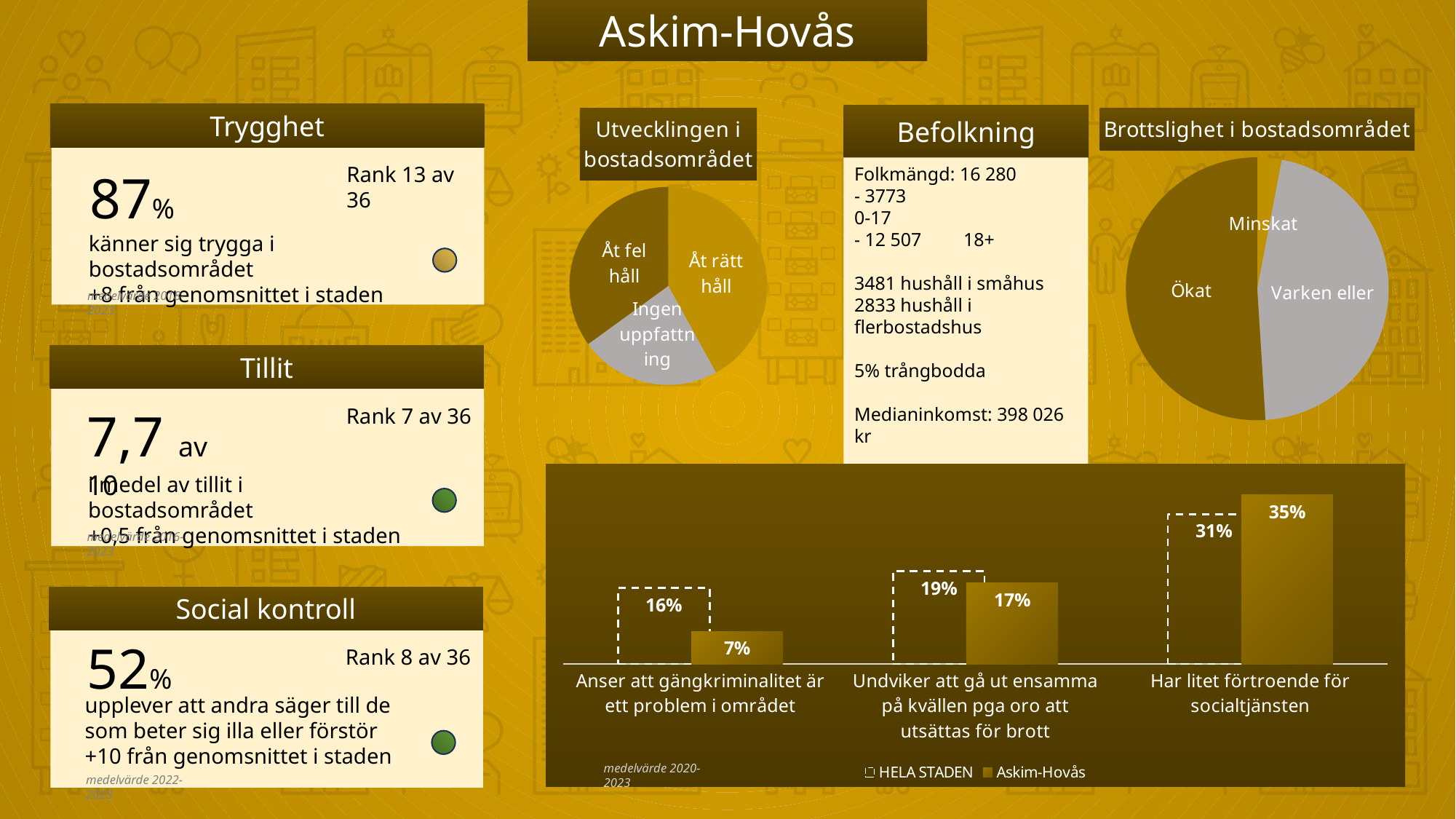
How many series does the legend of the bottom bar chart list? 2 In the 'Brottslighet i bostadsområdet' pie chart, which slice is the smallest? Minskat In the bottom bar chart, what is the Askim-Hovås value for 'Undviker att gå ut ensamma på kvällen pga oro att utsättas för brott'? 17% In the bottom bar chart, which category has the highest Askim-Hovås value? Har litet förtroende för socialtjänsten In the bottom bar chart, for 'Har litet förtroende för socialtjänsten', which is larger: HELA STADEN or Askim-Hovås? Askim-Hovås In the 'Utvecklingen i bostadsområdet' pie chart, which slice is the largest? Åt rätt håll In the bottom bar chart, which category has the lowest Askim-Hovås value? Anser att gängkriminalitet är ett problem i området What kind of chart is 'Utvecklingen i bostadsområdet'? Pie chart In the bottom bar chart, what is the Askim-Hovås value for 'Anser att gängkriminalitet är ett problem i området'? 7% How many categories are shown in the bottom bar chart? 3 In the bottom bar chart, what is the difference between the HELA STADEN and Askim-Hovås values for 'Anser att gängkriminalitet är ett problem i området'? 9% In the bottom bar chart, what is the HELA STADEN value for 'Har litet förtroende för socialtjänsten'? 31%